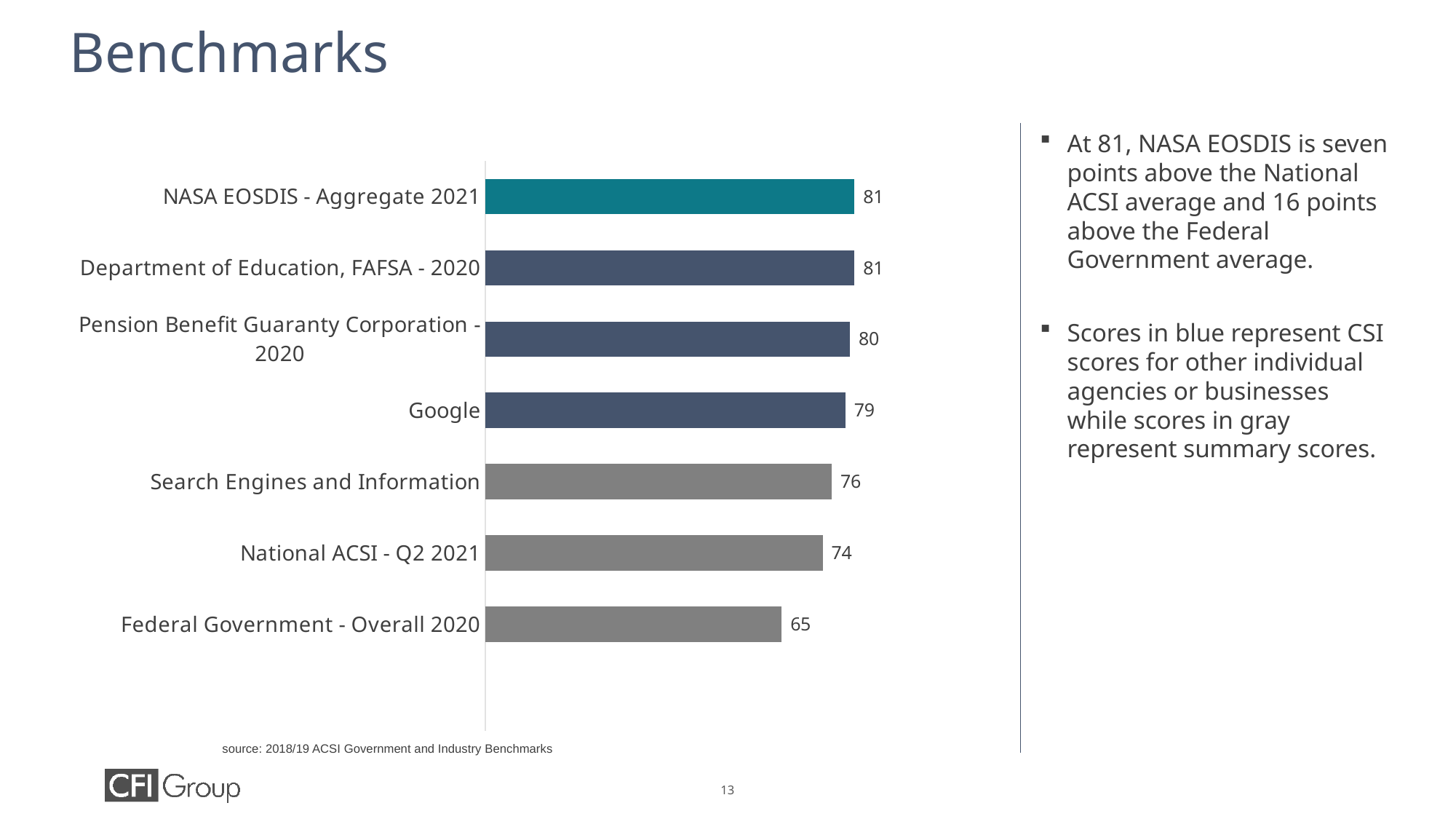
What is the value for National ACSI - Q2 2021? 74 What is the value for Pension Benefit Guaranty Corporation - 2020? 80 Which is larger, the value for Google or the value for Search Engines and Information? Google What colour is the bar for NASA EOSDIS - Aggregate 2021? Teal What is the value for Federal Government - Overall 2020? 65 What is the difference between the values for Search Engines and Information and National ACSI - Q2 2021? 2 Which category has the lowest value? Federal Government - Overall 2020 What is the value for Google? 79 What is the value for NASA EOSDIS - Aggregate 2021? 81 How many categories are shown in the chart? 7 What is the difference between the values for NASA EOSDIS - Aggregate 2021 and Federal Government - Overall 2020? 16 What kind of chart is shown on the slide? Bar chart